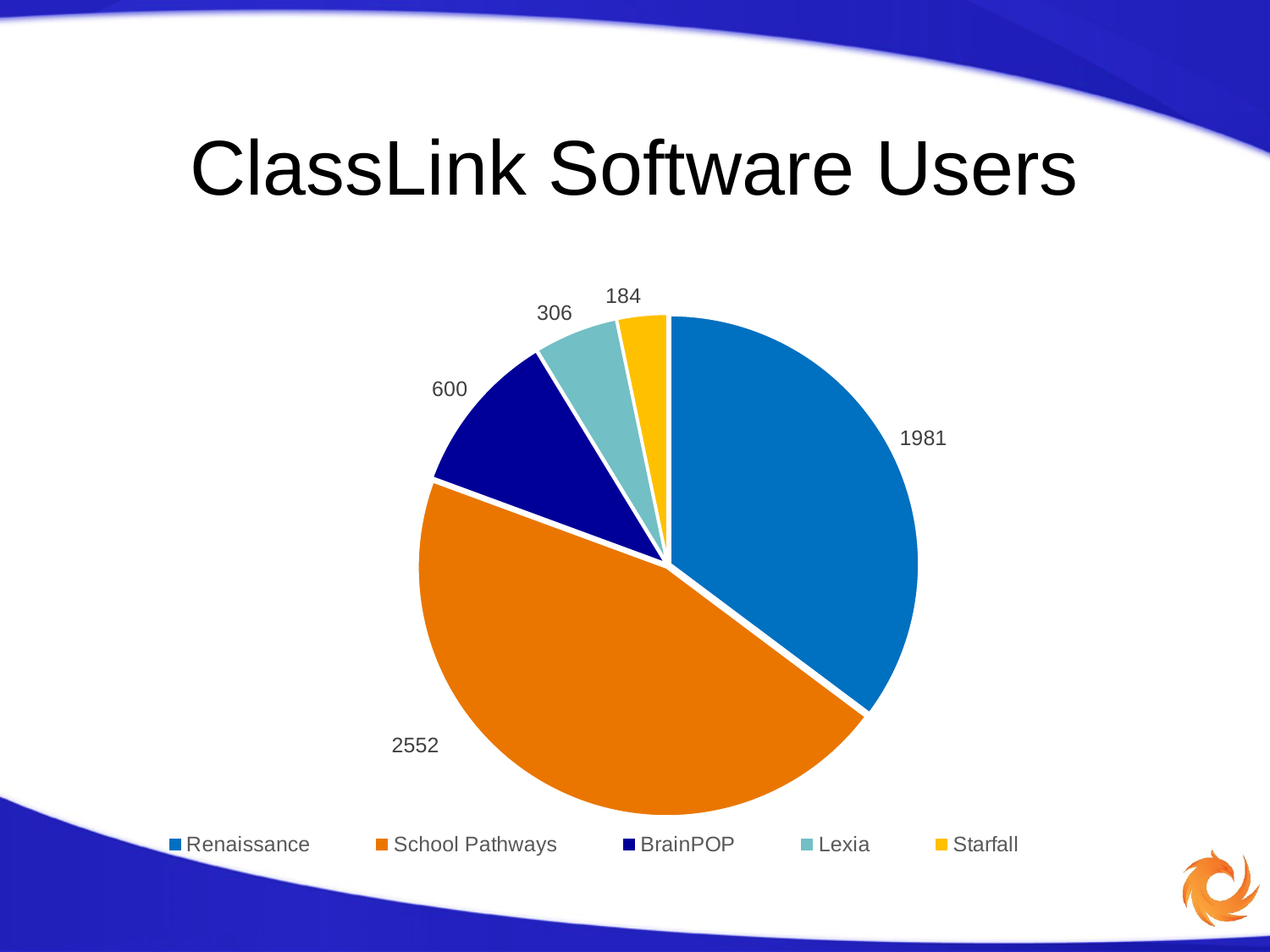
What is the value shown for Renaissance? 1981 Which software has the fewest users? Starfall Which has more users, BrainPOP or Lexia? BrainPOP How many users does School Pathways have? 2552 What type of chart is shown on the slide? Pie chart What is the value for Starfall? 184 How many software products are shown in the pie chart? 5 Which software has the most users? School Pathways How many users are shown for BrainPOP? 600 What is the title of the chart? ClassLink Software Users What is the difference in users between School Pathways and Renaissance? 571 What is the value for Lexia? 306